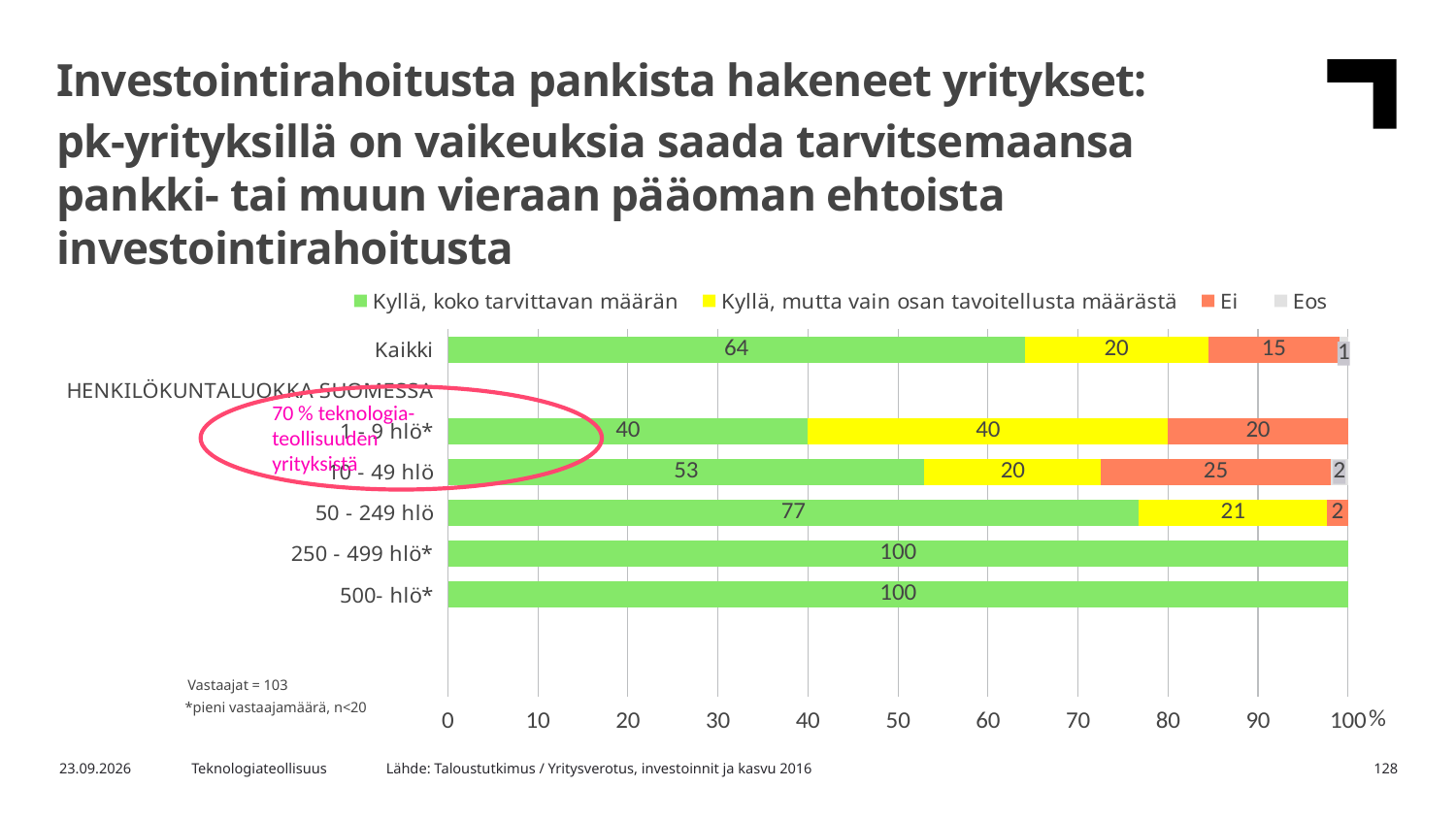
What is the value of 'Ei' for the category '10 - 49 hlö'? 25 What is the value of 'Kyllä, koko tarvittavan määrän' for the category 'Kaikki'? 64 What is the difference between the 'Kyllä, koko tarvittavan määrän' values for '50 - 249 hlö' and '10 - 49 hlö'? 24 What is the value of 'Kyllä, koko tarvittavan määrän' for the category '500- hlö*'? 100 How many categories are plotted on the chart? 6 What kind of chart is shown on the slide? stacked bar chart Which category has the highest value for 'Ei'? 10 - 49 hlö How many series does the legend list? 4 Which series is shown in green on the chart? Kyllä, koko tarvittavan määrän Which is larger: the 'Ei' value for 'Kaikki' or the 'Ei' value for '1 - 9 hlö*'? 1 - 9 hlö* What is the value of 'Kyllä, mutta vain osan tavoitellusta määrästä' for the category '50 - 249 hlö'? 21 Which category has the lowest value for 'Kyllä, koko tarvittavan määrän'? 1 - 9 hlö*